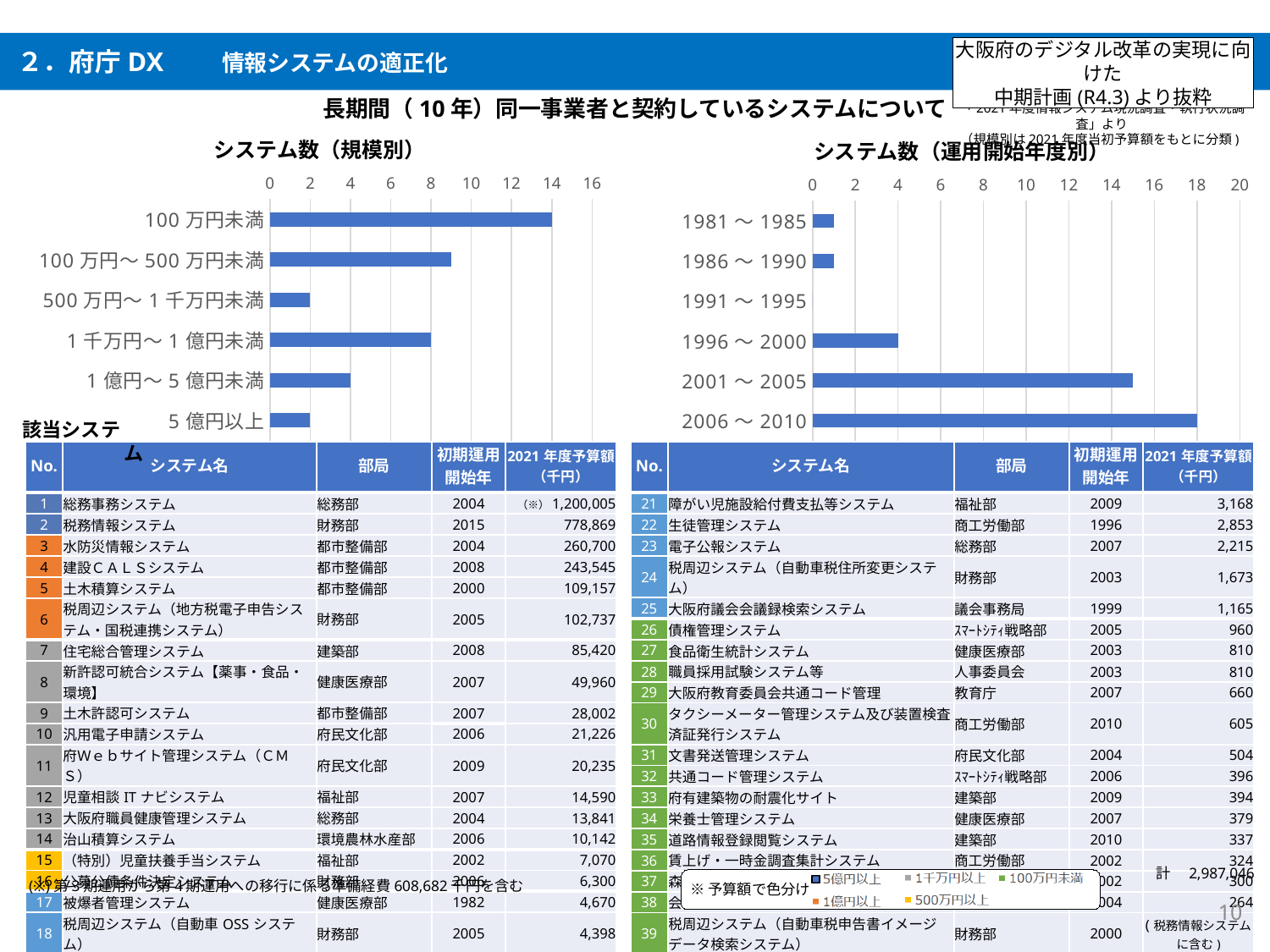
In the 「システム数（規模別）」 chart, is the value for 100万円～500万円未満 greater or less than 8? greater In the 「システム数（運用開始年度別）」 chart, which period has the highest number of systems? 2006～2010 What kind of chart is the 「システム数（規模別）」 chart on the left? bar chart In the 「システム数（規模別）」 chart, which is larger: 1千万円～1億円未満 or 1億円～5億円未満? 1千万円～1億円未満 In the 「システム数（運用開始年度別）」 chart, which period has the lowest number of systems? 1991～1995 In the 「システム数（規模別）」 chart, is the value for 1億円～5億円未満 greater or less than 6? less How many categories are shown in the 「システム数（規模別）」 chart? 6 In the 「システム数（運用開始年度別）」 chart, is the value for 2001～2005 greater or less than 14? greater In the 「システム数（運用開始年度別）」 chart, which is larger: 1996～2000 or 2001～2005? 2001～2005 How many period categories are shown in the 「システム数（運用開始年度別）」 chart? 6 In the 「システム数（規模別）」 chart, which category has the highest number of systems? 100万円未満